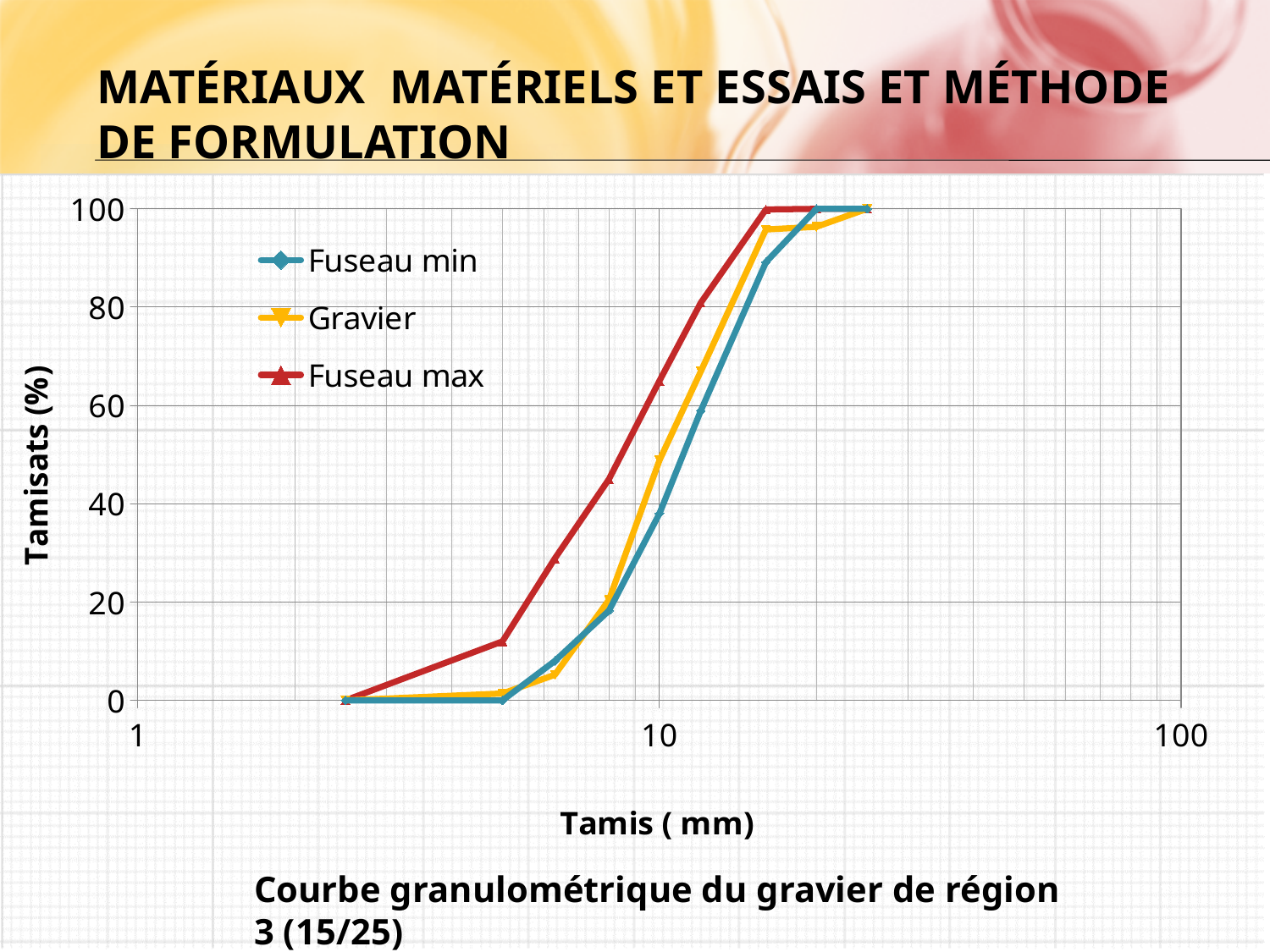
At a sieve size of 10 mm, which of the three series has the lowest value? Fuseau min At a sieve size of 10 mm, is the value for Gravier greater or less than 60? less At a sieve size of 10 mm, which series has the higher value, Fuseau max or Fuseau min? Fuseau max At a sieve size of 10 mm, which series has the higher value, Gravier or Fuseau min? Gravier At a sieve size of 10 mm, is the value for Fuseau max greater or less than 60? greater At a sieve size of 10 mm, is the value for Fuseau min greater or less than 60? less How many series does the legend list? 3 What kind of chart is shown on the slide? line chart What is the title of the y axis? Tamisats (%) What are the three series named in the legend? Fuseau min, Gravier, Fuseau max Do the values of the Gravier series rise or fall as the sieve size (Tamis) increases along the x axis? rise